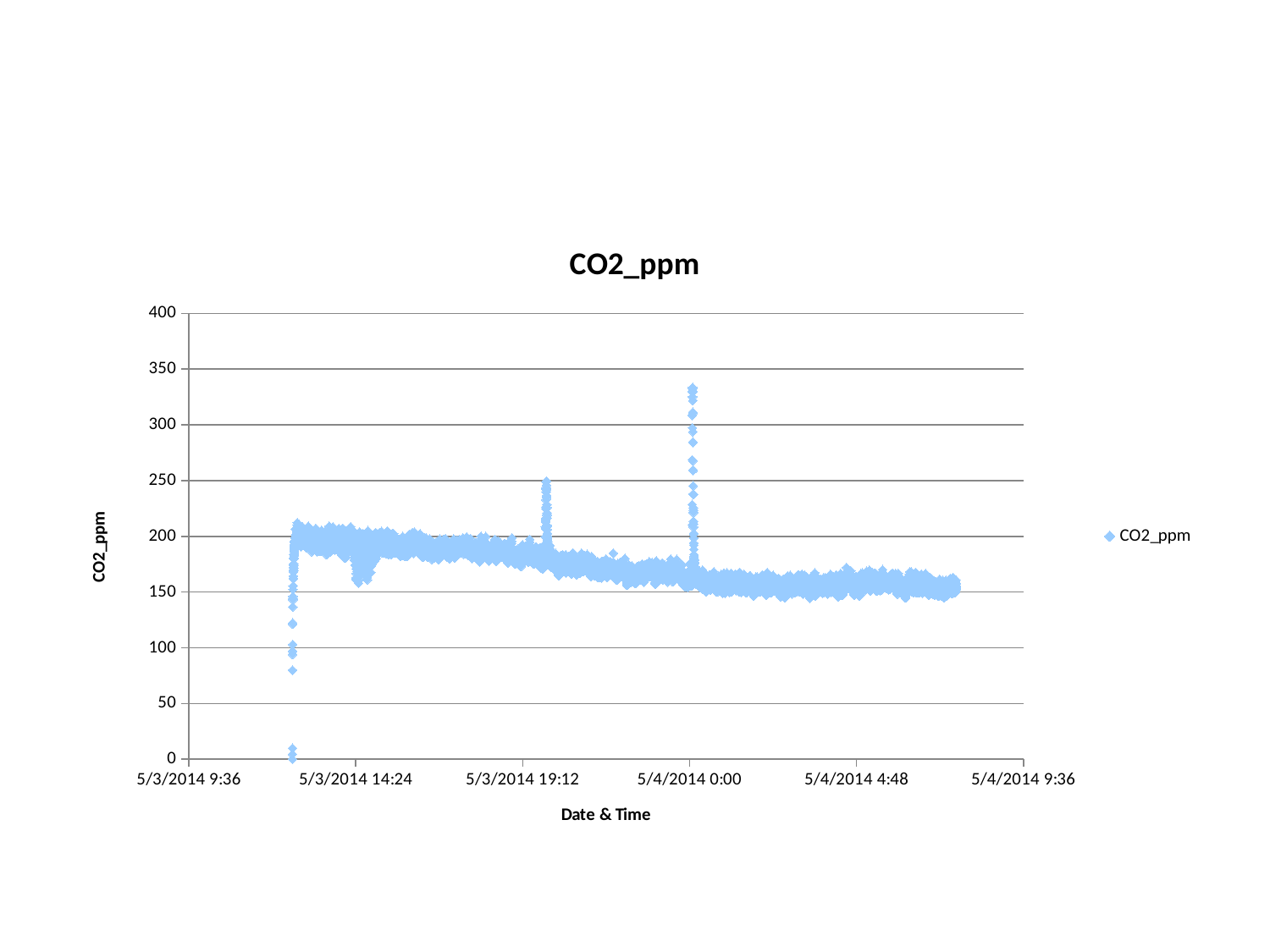
What kind of chart is shown on the slide? scatter chart Which is larger: the peak of the spike near 5/4/2014 0:00 or the peak of the spike near 5/3/2014 19:12? the spike near 5/4/2014 0:00 Ignoring the spikes, do the CO2_ppm values generally rise or fall from 5/3/2014 14:24 to 5/4/2014 4:48? fall Is the highest CO2_ppm value on the chart greater or less than 350? less Is the peak of the spike near 5/3/2014 19:12 greater or less than 200? greater Is the peak of the spike near 5/3/2014 19:12 greater or less than 300? less What is the label of the x axis? Date & Time How many series does the legend list? 1 What is the title of the chart? CO2_ppm Around which x-axis tick does the highest CO2_ppm spike occur? 5/4/2014 0:00